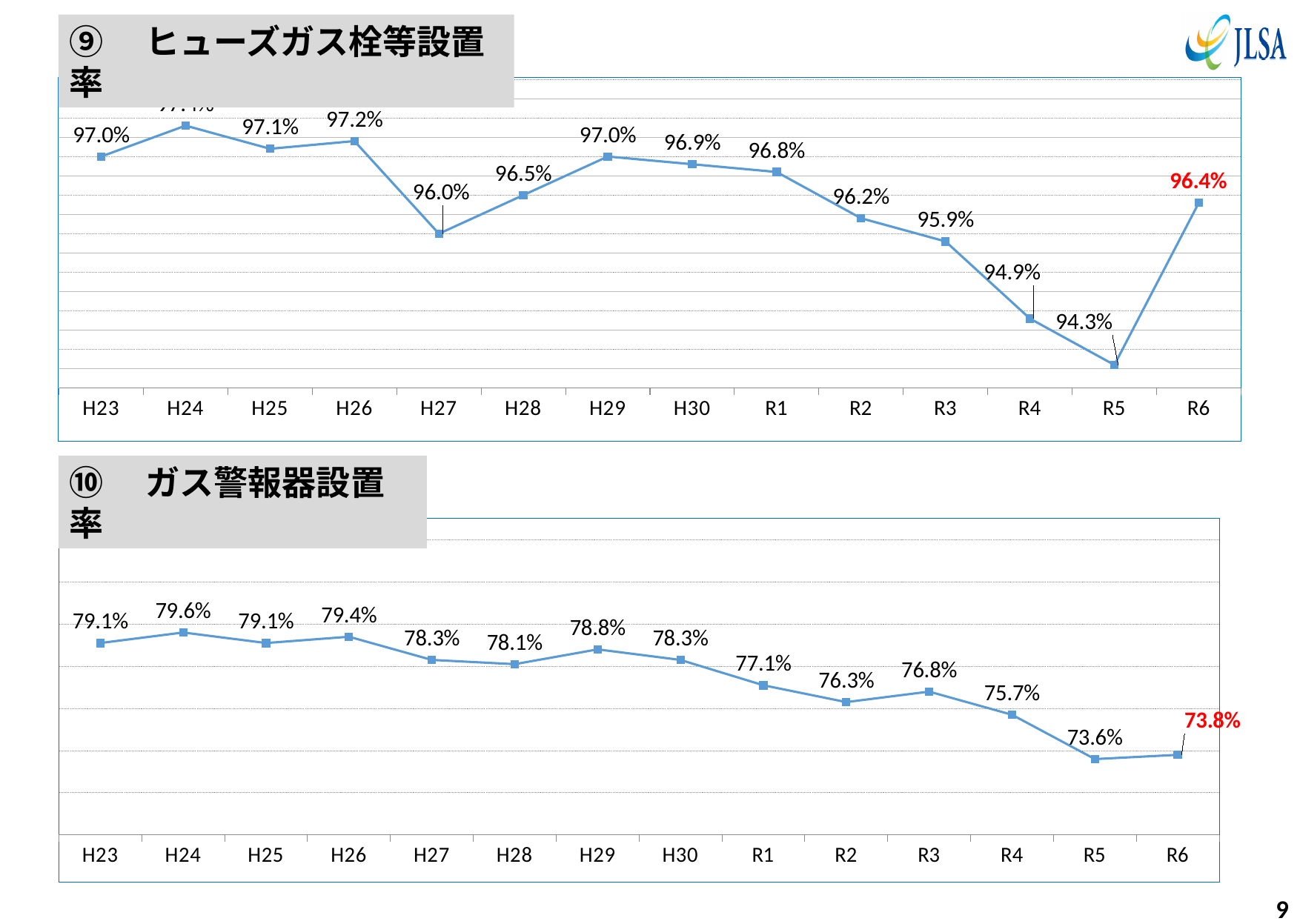
In the top chart (⑨ ヒューズガス栓等設置率), what is the difference between the R6 value and the R5 value? 2.1% In the top chart (⑨ ヒューズガス栓等設置率), what is the value for H27? 96.0% In the top chart (⑨ ヒューズガス栓等設置率), which is larger, the value for H29 or the value for R2? H29 In the top chart (⑨ ヒューズガス栓等設置率), how many years are plotted on the x axis? 14 In the top chart (⑨ ヒューズガス栓等設置率), what is the value for R6? 96.4% In the bottom chart (⑩ ガス警報器設置率), what is the overall trend of the values from H23 to R6? Falling In the bottom chart (⑩ ガス警報器設置率), what is the difference between the H23 value and the R6 value? 5.3% In the bottom chart (⑩ ガス警報器設置率), which year has the lowest value? R5 In the bottom chart (⑩ ガス警報器設置率), what is the value for R6? 73.8% What type of chart is the bottom chart (⑩ ガス警報器設置率)? Line chart In the bottom chart (⑩ ガス警報器設置率), which year has the highest value? H24 In the top chart (⑨ ヒューズガス栓等設置率), which year has the lowest value? R5